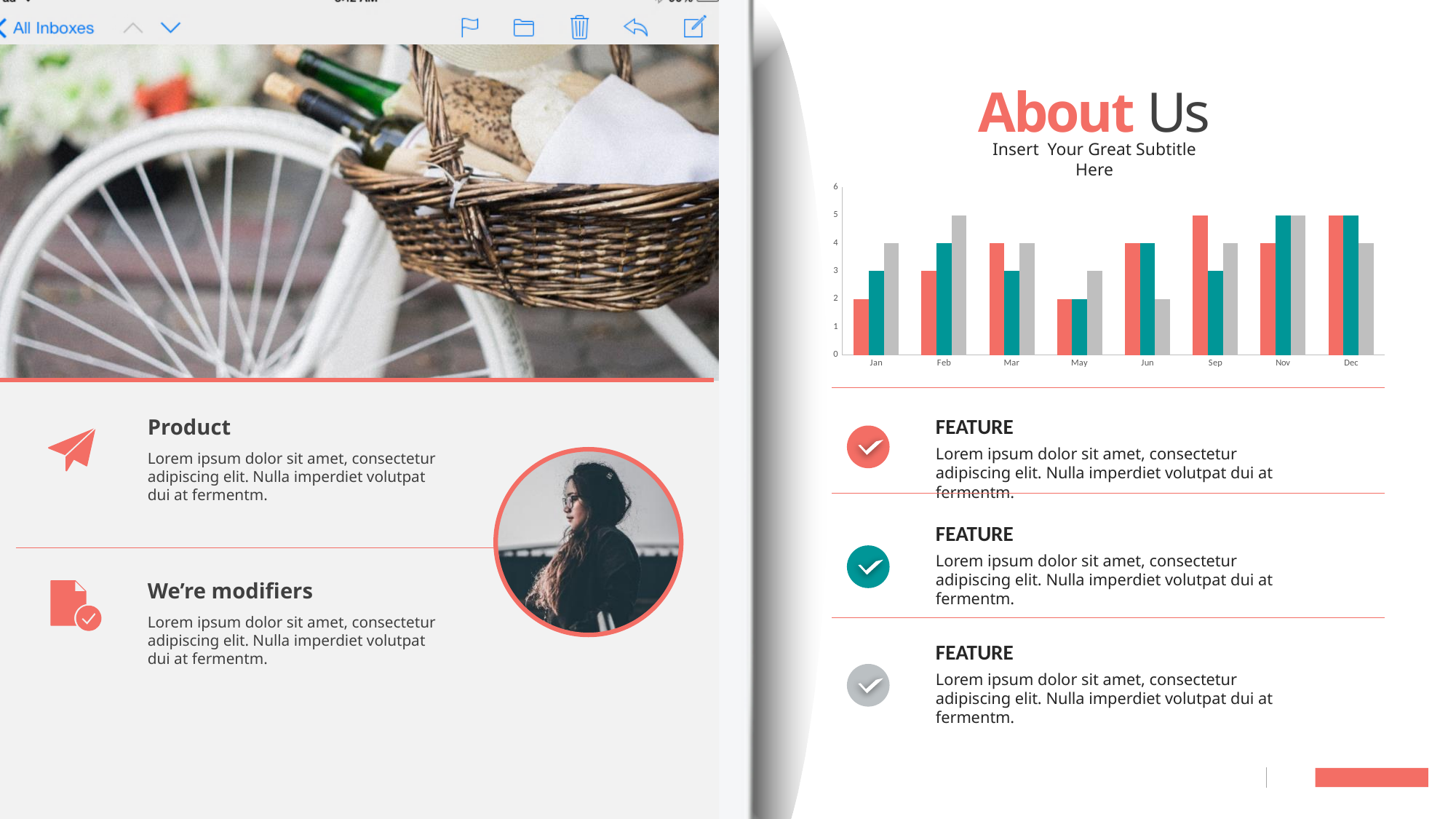
Which month has the lowest teal bar? May What is the value of the gray bar for Jun? 2 How many months are shown on the x axis of the chart? 8 Is the value of the coral (red) bar for Sep greater or less than 4? greater What is the highest value shown on the chart's y axis? 6 For Jan, which is larger: the coral (red) bar or the gray bar? gray bar What is the difference between the gray bar and the coral (red) bar for Feb? 2 What is the value of the teal bar for May? 2 What is the value of the coral (red) bar for Sep? 5 What is the value of the gray bar for Feb? 5 Which month has the lowest gray bar? Jun What kind of chart is shown on the slide? bar chart